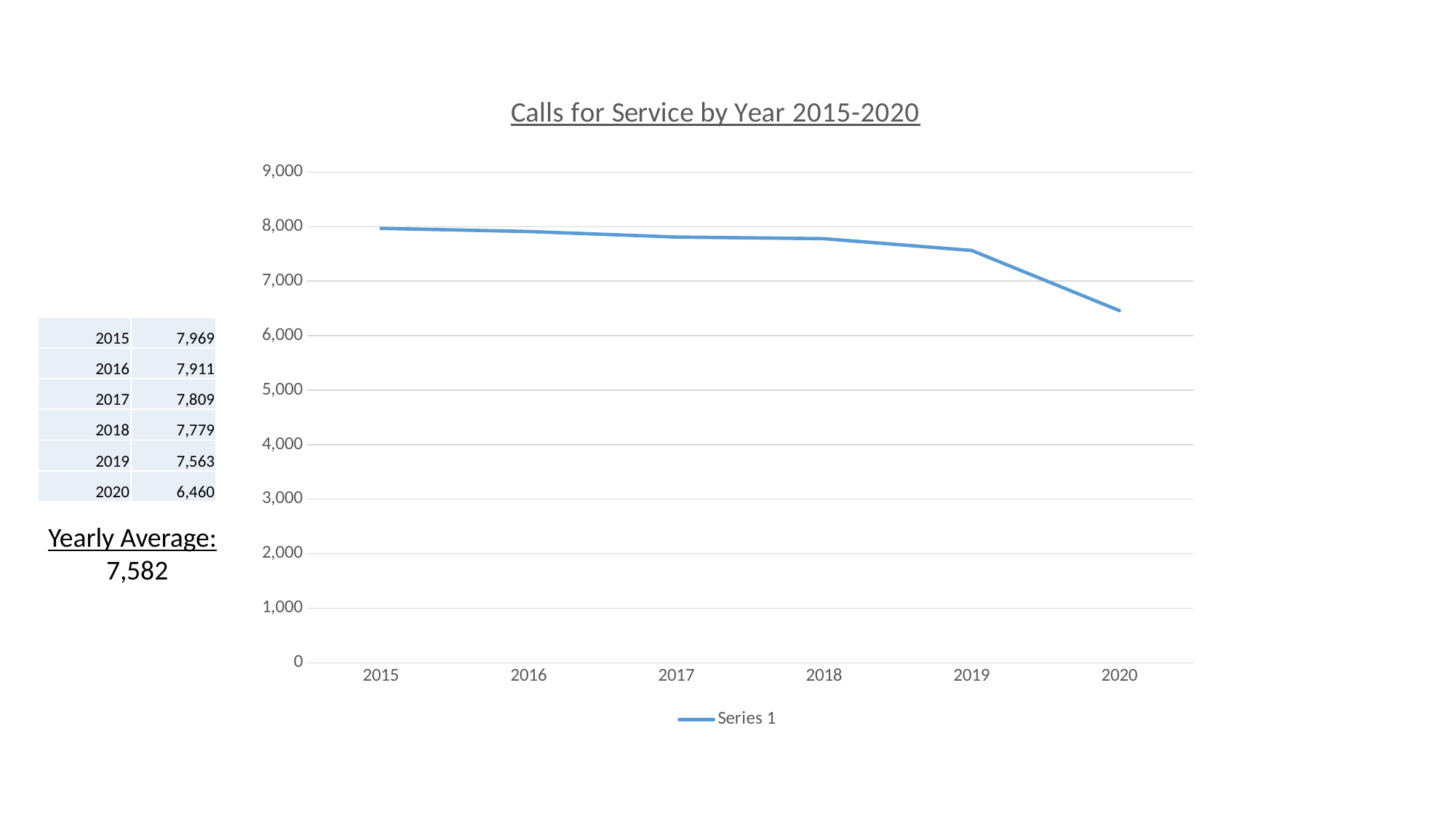
How many series does the legend list? 1 Which year has the highest number of calls for service? 2015 What kind of chart is shown on the slide? line chart Do the values rise or fall from 2015 to 2020? fall Is the value for 2020 greater or less than 7,000? less How many years are plotted on the x axis? 6 What is the difference between the values for 2019 and 2020? 1,103 What is the value for 2015 according to the table on the slide? 7,969 What is the title of the chart? Calls for Service by Year 2015-2020 What is the value for 2020 according to the table on the slide? 6,460 Which year has the lowest number of calls for service? 2020 What is the value for 2018 according to the table on the slide? 7,779